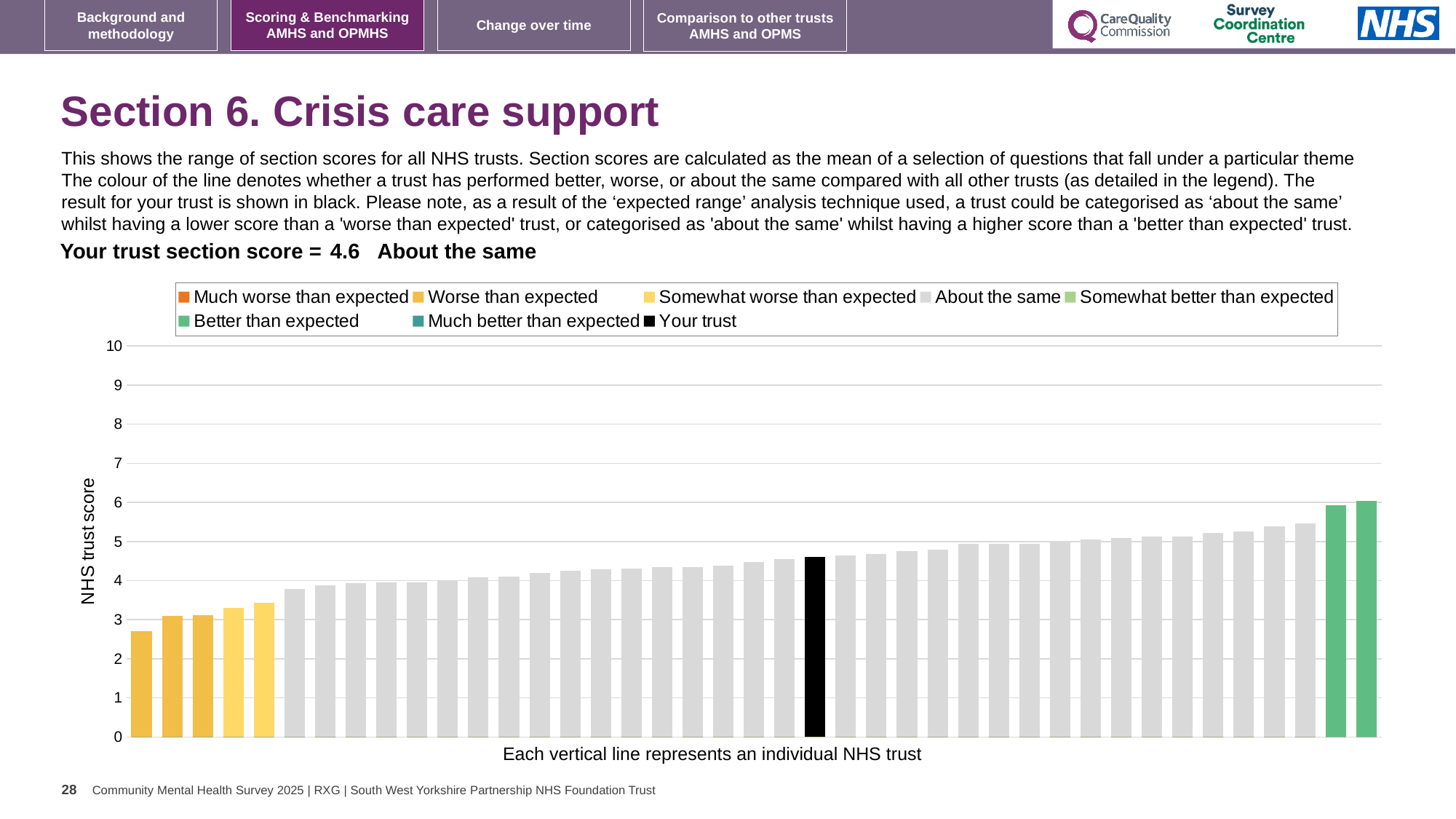
Which category does your trust fall into according to the slide? About the same How many entries does the chart legend list? 8 Is the black 'Your trust' bar higher or lower than the leftmost bar? higher Is the value of the leftmost (lowest) bar greater or less than 3? less How many bars are coloured green ('Better than expected')? 2 Do the bar values rise or fall from left to right along the x axis? rise What is the section score for your trust shown on the slide? 4.6 Is the value of the black 'Your trust' bar greater or less than 4? greater What is the title of the vertical axis? NHS trust score What kind of chart is shown on the slide? bar chart Is the value of the black 'Your trust' bar greater or less than 5? less